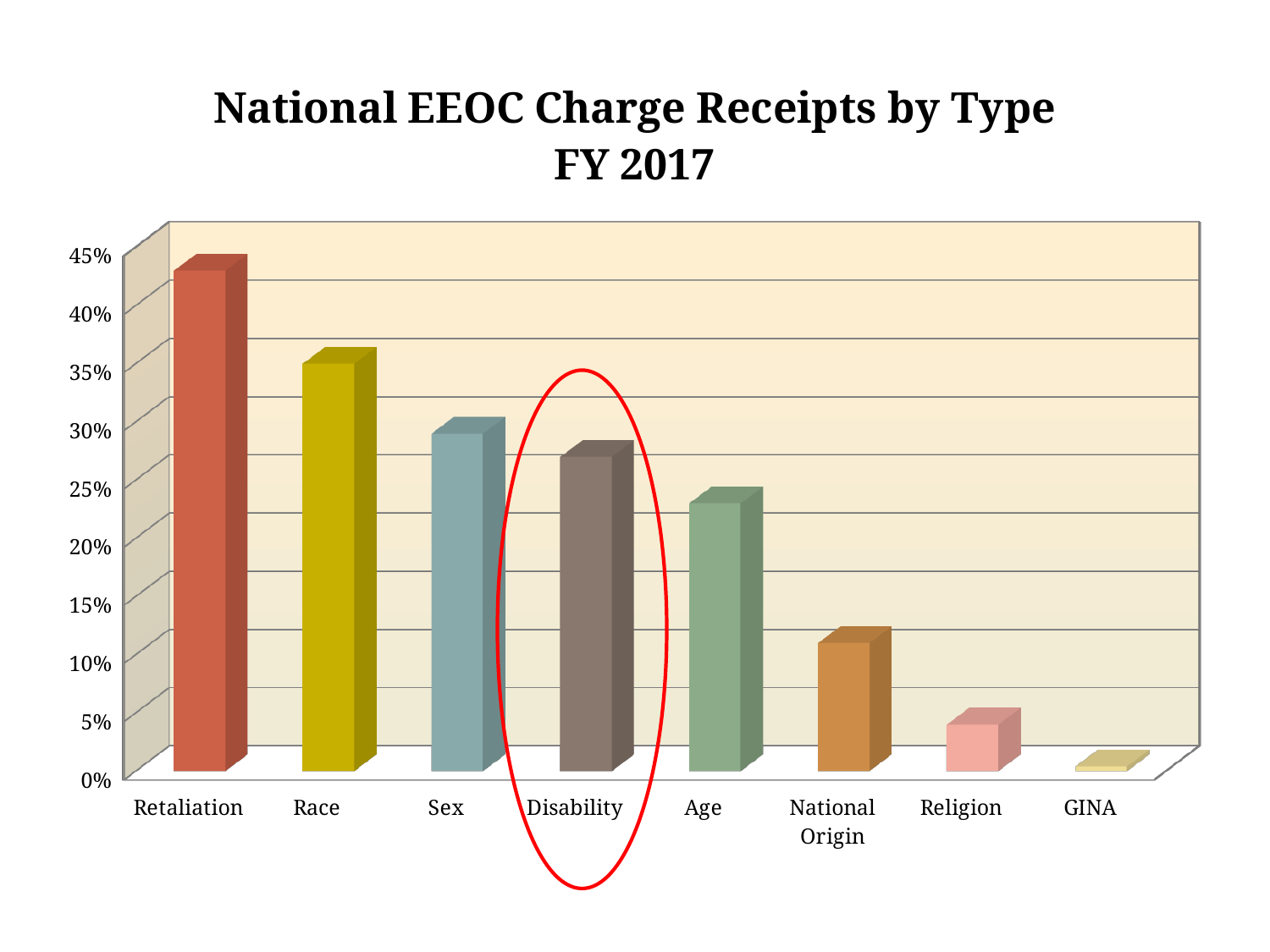
What type of chart is shown on the slide? bar chart How many charge types (categories) are shown on the x axis? 8 Which category on the chart is circled in red? Disability Is the value for National Origin greater or less than 15%? less Is the value for Race greater or less than 30%? greater Which is larger, the value for Race or the value for Sex? Race Do the values rise or fall moving from left to right along the x axis? fall Is the value for Religion greater or less than 10%? less Which charge type has the lowest share of EEOC charge receipts? GINA Which charge type has the highest share of EEOC charge receipts? Retaliation